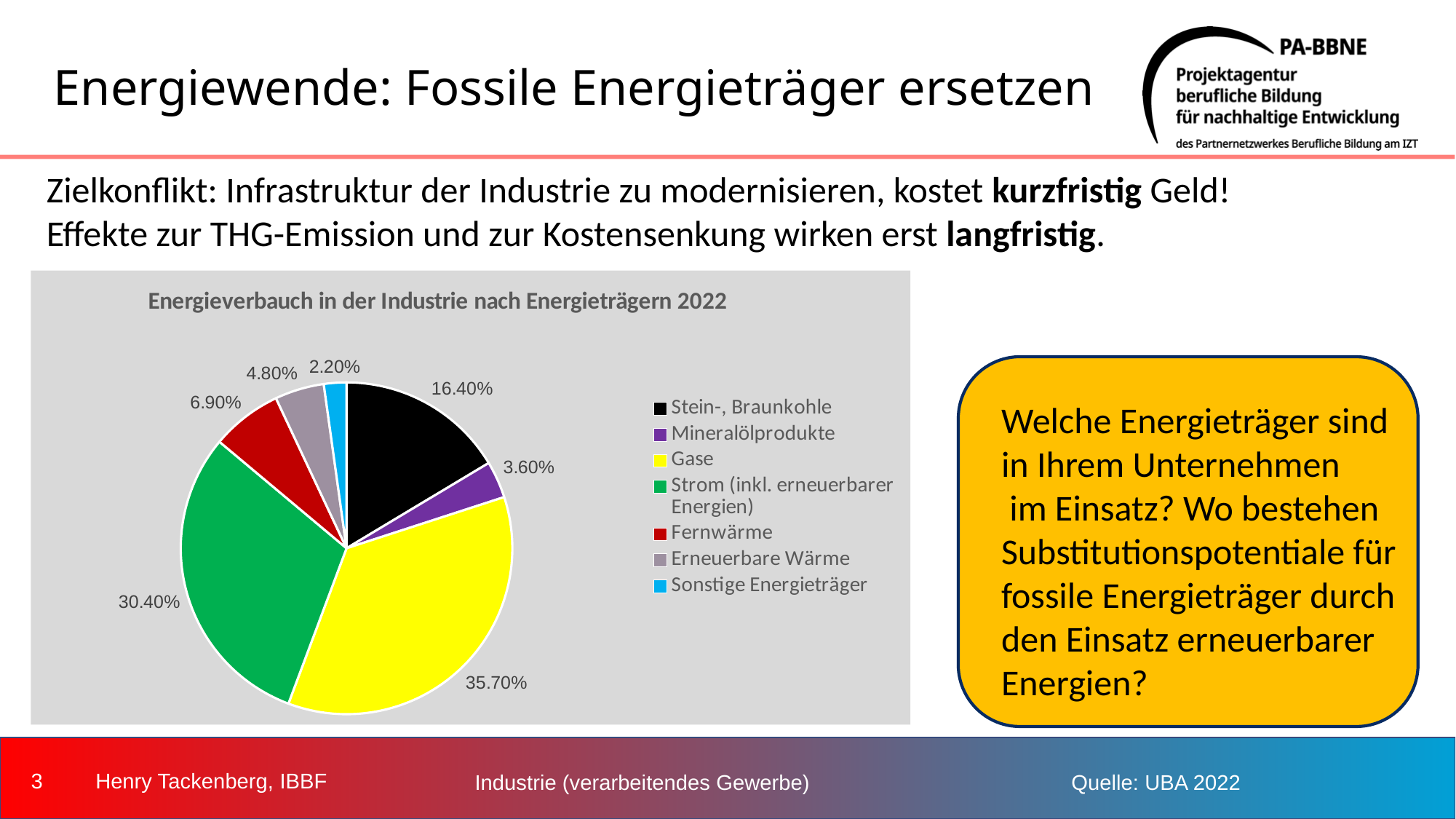
What share of the pie does Stein-, Braunkohle have? 16.40% What is the title of the chart? Energieverbauch in der Industrie nach Energieträgern 2022 Which has the larger share, Erneuerbare Wärme or Mineralölprodukte? Erneuerbare Wärme How many categories does the legend list? 7 What share of the pie does Sonstige Energieträger have? 2.20% Which energy source has the smallest share of the pie? Sonstige Energieträger What share of the pie does Fernwärme have? 6.90% What is the difference between the shares of Gase and Strom (inkl. erneuerbarer Energien)? 5.30% What kind of chart is shown on the slide? pie chart Which energy source has the largest share of the pie? Gase What share of the pie does Gase have? 35.70% What share of the pie does Strom (inkl. erneuerbarer Energien) have? 30.40%